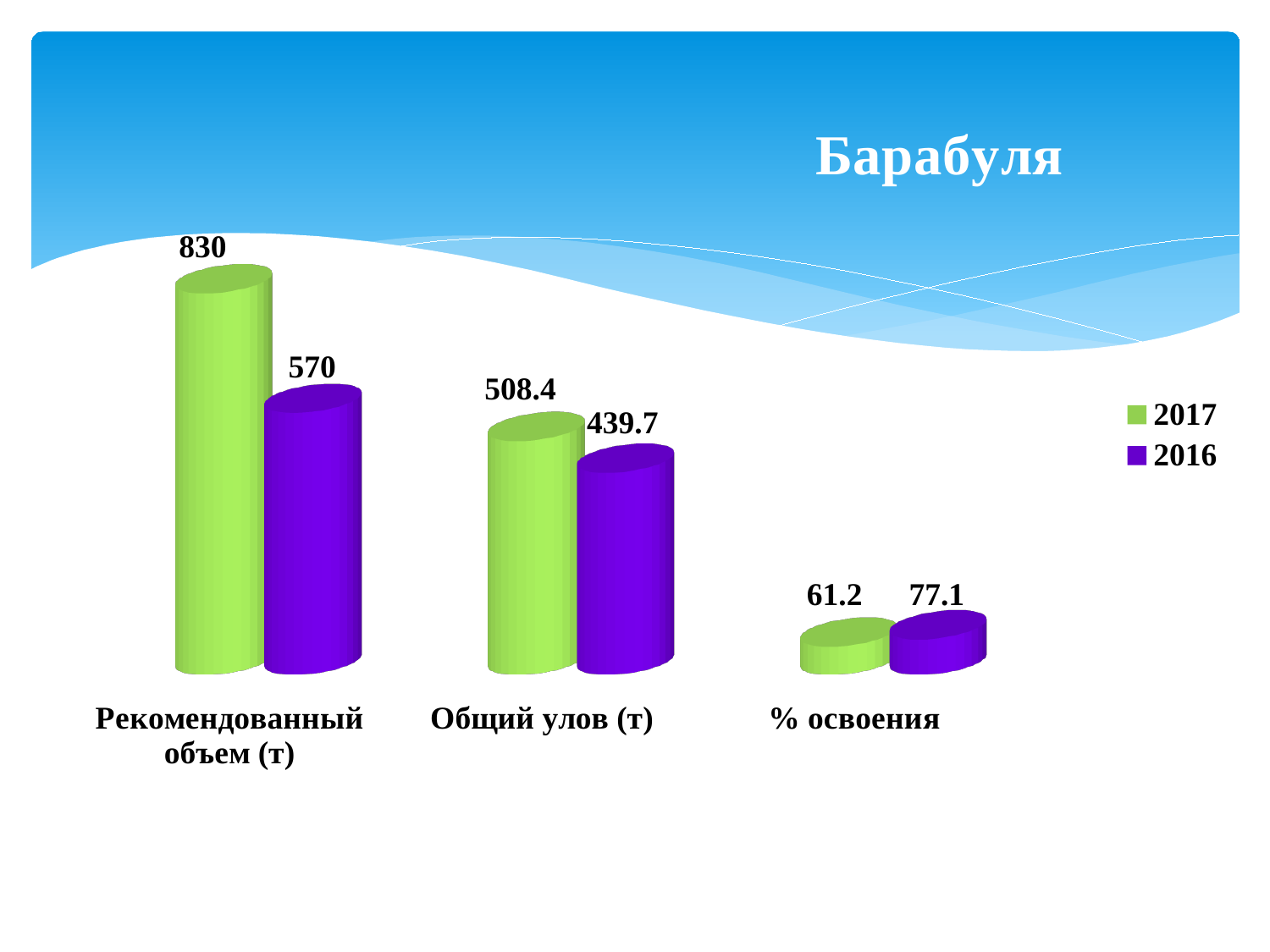
In the 'Общий улов (т)' category, which year has the larger value, 2017 or 2016? 2017 What is the difference between the 2016 and 2017 values in the '% освоения' category? 15.9 Which category has the highest value for the 2017 series? Рекомендованный объем (т) What is the value for 2016 in the 'Рекомендованный объем (т)' category? 570 What is the value for 2017 in the 'Рекомендованный объем (т)' category? 830 How many series does the legend list? 2 In the '% освоения' category, which year has the larger value, 2017 or 2016? 2016 How many categories are shown on the x axis? 3 What is the value for 2016 in the 'Общий улов (т)' category? 439.7 What is the value for 2017 in the '% освоения' category? 61.2 What is the difference between the 2017 and 2016 values in the 'Рекомендованный объем (т)' category? 260 Which category has the lowest value for the 2016 series? % освоения